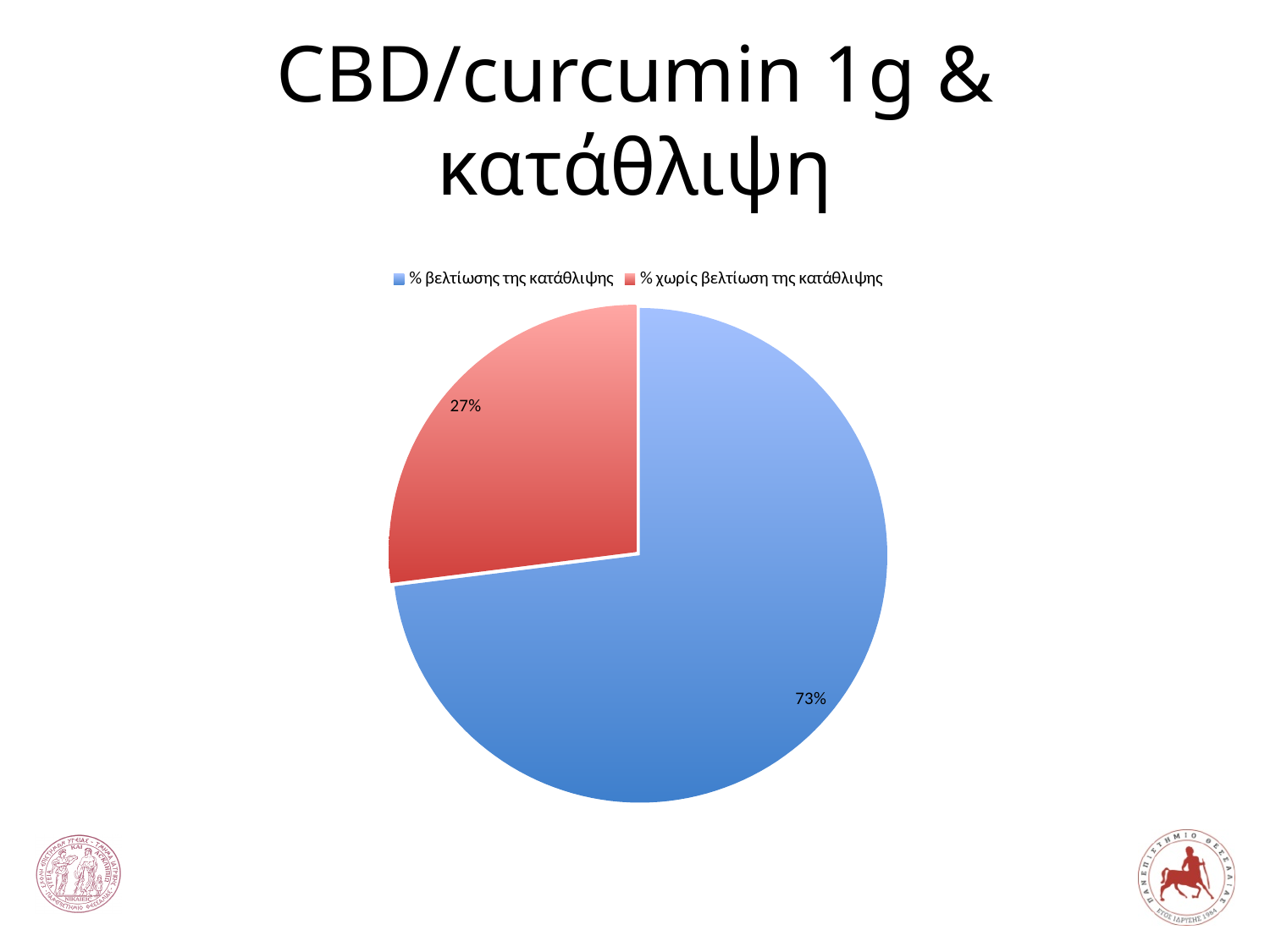
Which slice of the pie is the smallest? % χωρίς βελτίωση της κατάθλιψης How many entries does the legend list? 2 What percentage is shown for "% χωρίς βελτίωση της κατάθλιψης"? 27% What is the title of the slide containing the pie chart? CBD/curcumin 1g & κατάθλιψη Which slice of the pie is the largest? % βελτίωσης της κατάθλιψης How many slices does the pie chart have? 2 What percentage is shown for "% βελτίωσης της κατάθλιψης"? 73% What is the difference in percentage points between the "% βελτίωσης της κατάθλιψης" slice and the "% χωρίς βελτίωση της κατάθλιψης" slice? 46 percentage points Which is larger: the share for "% βελτίωσης της κατάθλιψης" or the share for "% χωρίς βελτίωση της κατάθλιψης"? % βελτίωσης της κατάθλιψης What share of the pie does the blue slice represent? 73% What colour is the slice for "% χωρίς βελτίωση της κατάθλιψης"? red What kind of chart is shown on the slide? pie chart